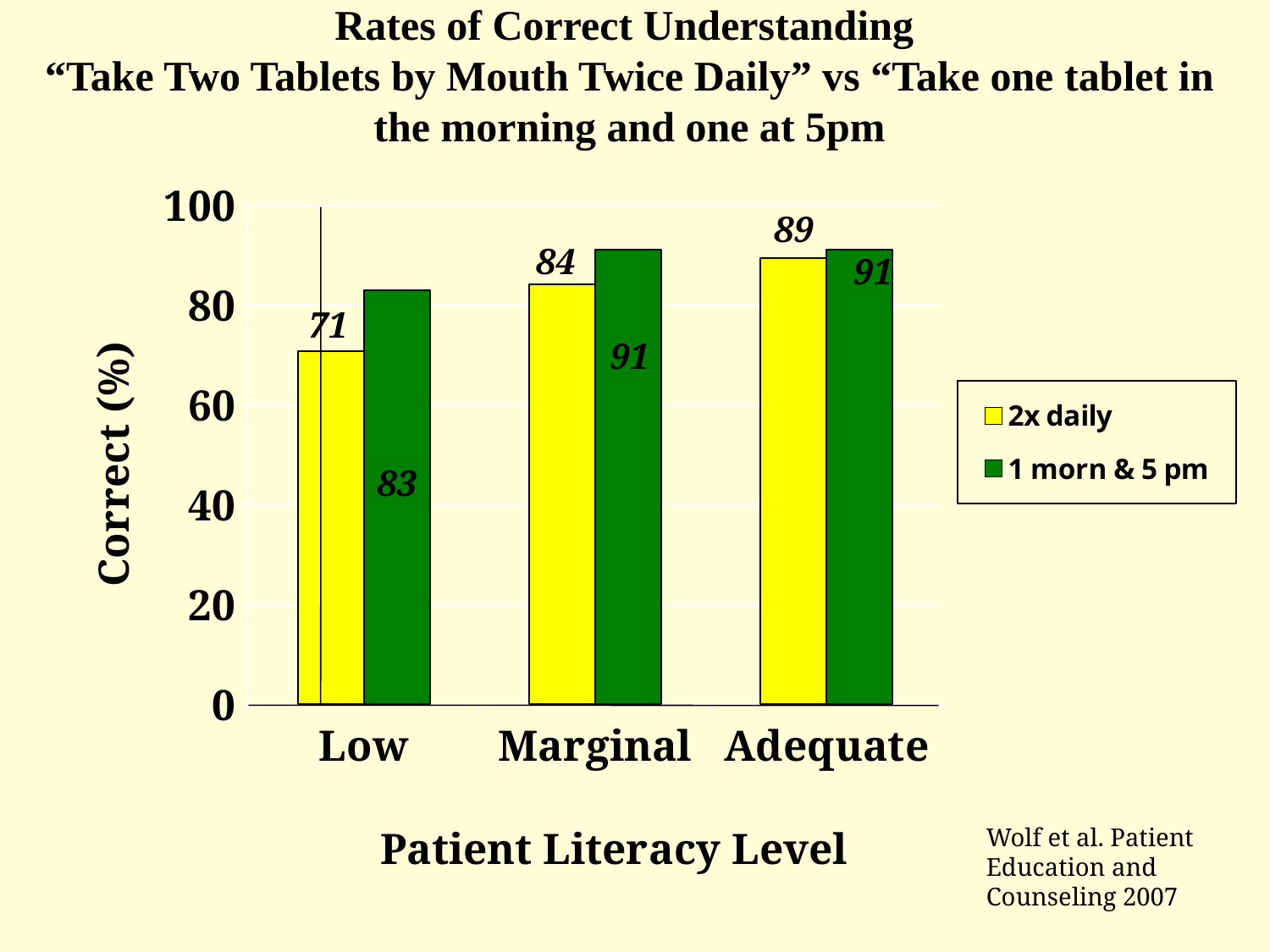
Which literacy level has the highest value for the 2x daily series? Adequate How many literacy levels are shown on the x axis? 3 What is the value for the 1 morn & 5 pm series at the Low literacy level? 83 What is the difference between the 1 morn & 5 pm and 2x daily values at the Low literacy level? 12 Do the 2x daily values rise or fall from Low to Adequate literacy level? Rise What is the value for the 1 morn & 5 pm series at the Adequate literacy level? 91 How many series does the legend list? 2 Which literacy level has the lowest value for the 2x daily series? Low What is the value for the 2x daily series at the Marginal literacy level? 84 What kind of chart is shown on the slide? Bar chart What is the value for the 2x daily series at the Low literacy level? 71 Which is larger at the Marginal literacy level: the 2x daily value or the 1 morn & 5 pm value? 1 morn & 5 pm